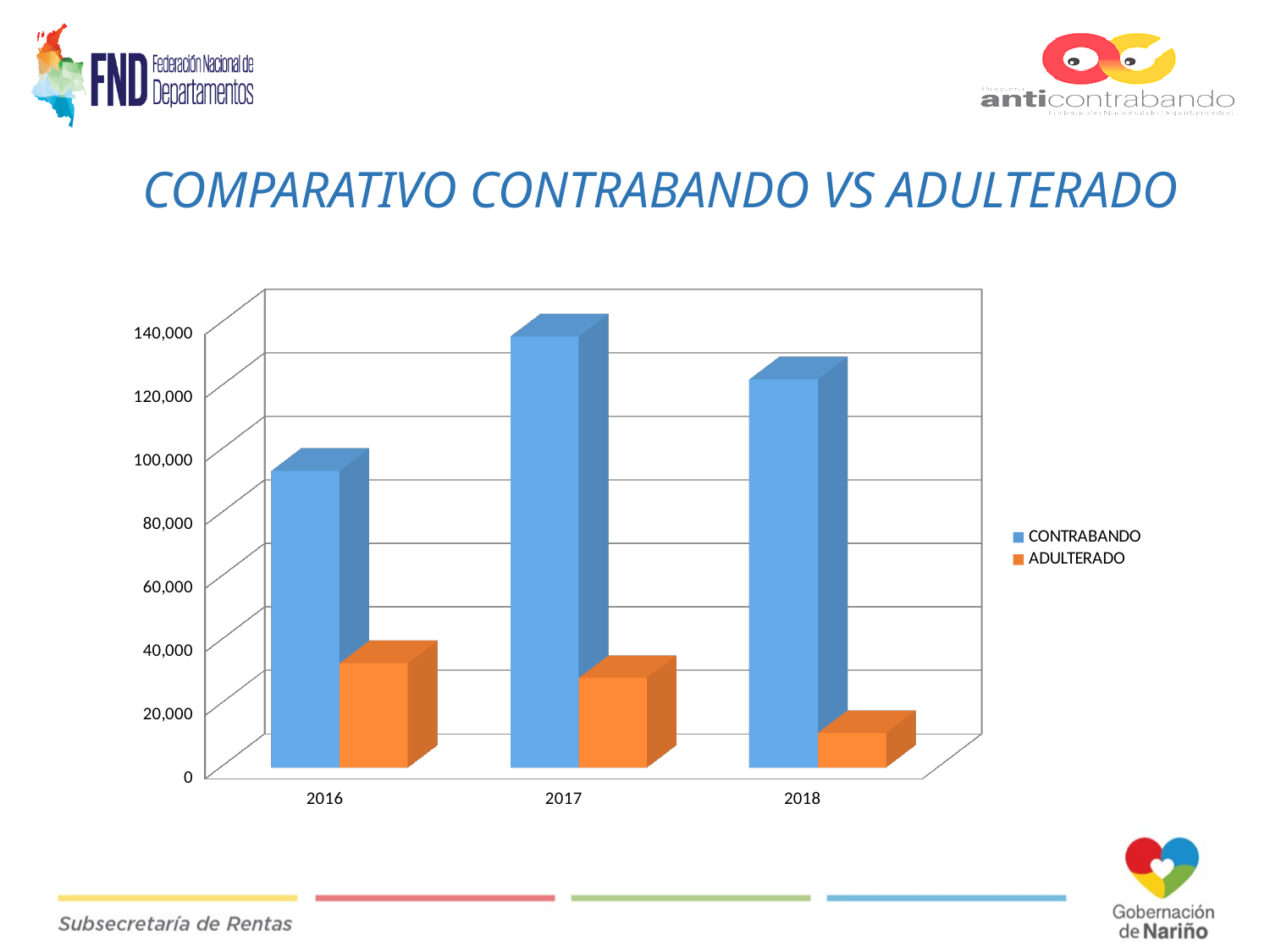
How many years are shown on the x axis? 3 Which year has the lowest ADULTERADO value? 2018 How many series does the legend list? 2 Which year has the lowest CONTRABANDO value? 2016 Does the ADULTERADO series rise or fall from 2016 to 2018? fall What kind of chart is shown on the slide? bar chart In 2018, which is larger, CONTRABANDO or ADULTERADO? CONTRABANDO Is the CONTRABANDO value for 2017 greater or less than 120,000? greater Is the CONTRABANDO value for 2016 greater or less than 80,000? greater Which year has the highest CONTRABANDO value? 2017 What is the title of the chart? COMPARATIVO CONTRABANDO VS ADULTERADO Is the ADULTERADO value for 2018 greater or less than 20,000? less